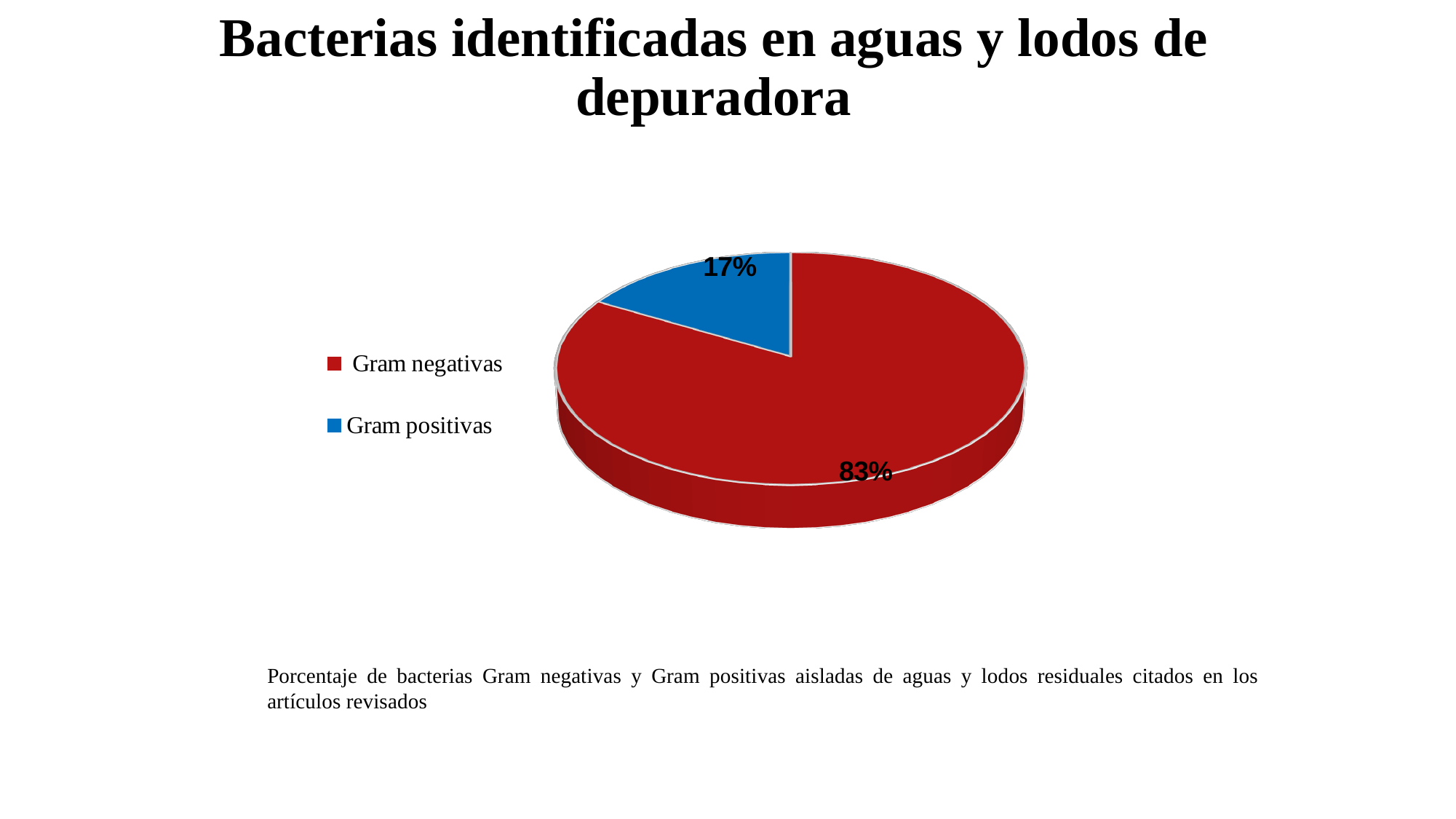
What percentage of the pie is Gram negativas? 83% What kind of chart is shown on the slide? Pie chart How many entries does the legend list? 2 How many slices does the pie chart have? 2 Which category has the smallest share of the pie? Gram positivas Which is larger, the share for Gram negativas or for Gram positivas? Gram negativas What percentage of the pie is Gram positivas? 17% What colour is the Gram positivas slice? Blue Which category has the largest share of the pie? Gram negativas What is the title of the slide containing the chart? Bacterias identificadas en aguas y lodos de depuradora What is the difference in percentage points between Gram negativas and Gram positivas? 66